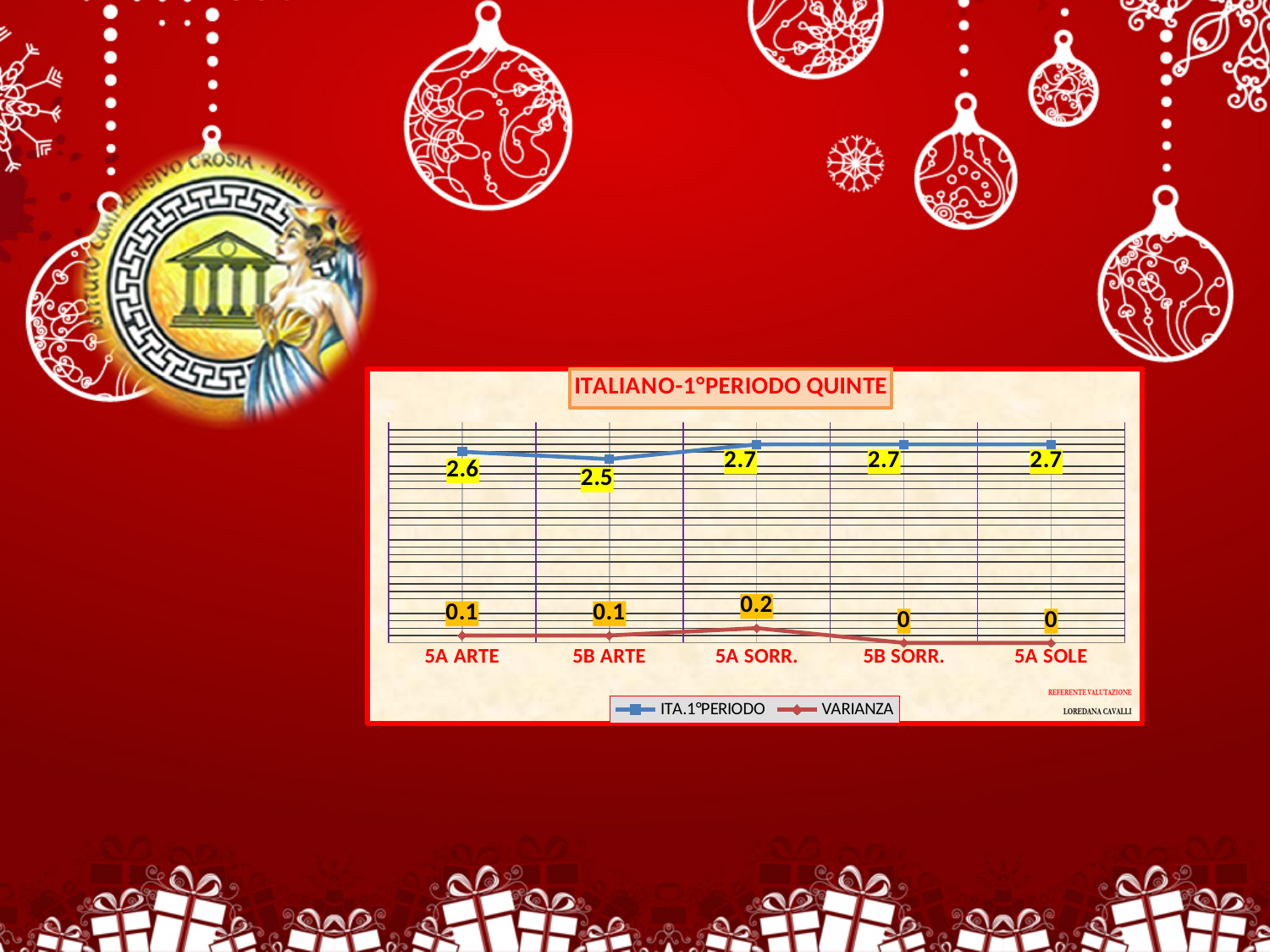
What is the ITA.1°PERIODO value for 5B ARTE? 2.5 How many categories are shown on the x axis? 5 What is the VARIANZA value for 5A SORR.? 0.2 What is the ITA.1°PERIODO value for 5A ARTE? 2.6 Which category has the lowest ITA.1°PERIODO value? 5B ARTE What type of chart is shown on the slide? line chart Which is larger, the ITA.1°PERIODO value for 5A ARTE or for 5B ARTE? 5A ARTE Which category has the highest VARIANZA value? 5A SORR. What is the VARIANZA value for 5A SOLE? 0 What is the title of the chart? ITALIANO-1°PERIODO QUINTE What is the difference between the ITA.1°PERIODO values for 5A SORR. and 5B ARTE? 0.2 How many series does the legend list? 2